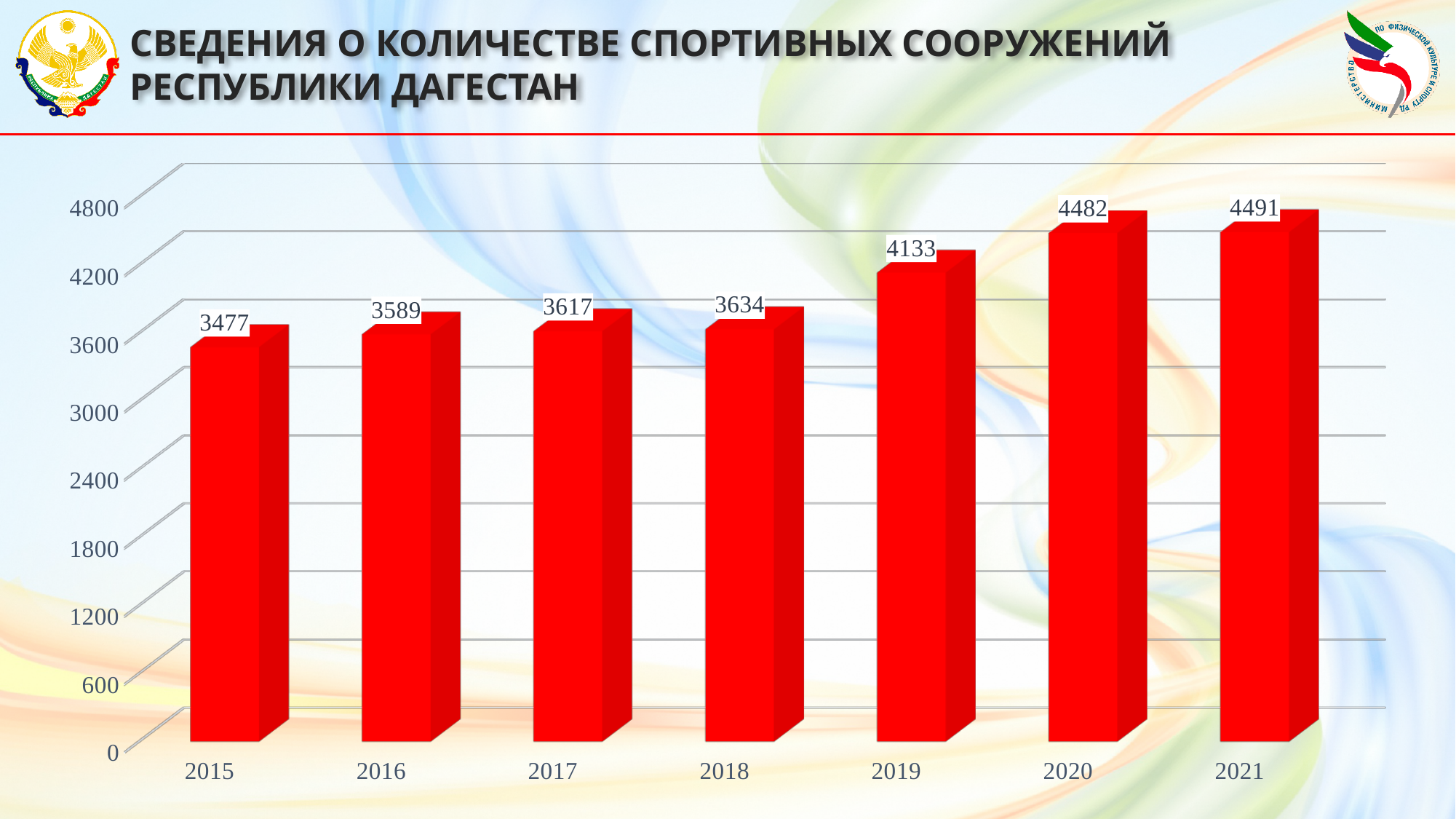
Is the value for 2017 greater or less than 4200? less Which is larger, the value for 2018 or the value for 2016? 2018 How many years are shown on the x axis? 7 What is the difference between the values for 2021 and 2015? 1014 What is the value for 2021? 4491 What is the value for 2019? 4133 What is the value for 2015? 3477 What is the difference between the values for 2020 and 2019? 349 What kind of chart is shown on the slide? bar chart Which year has the highest value? 2021 Which year has the lowest value? 2015 Do the values rise or fall from 2015 to 2021? rise